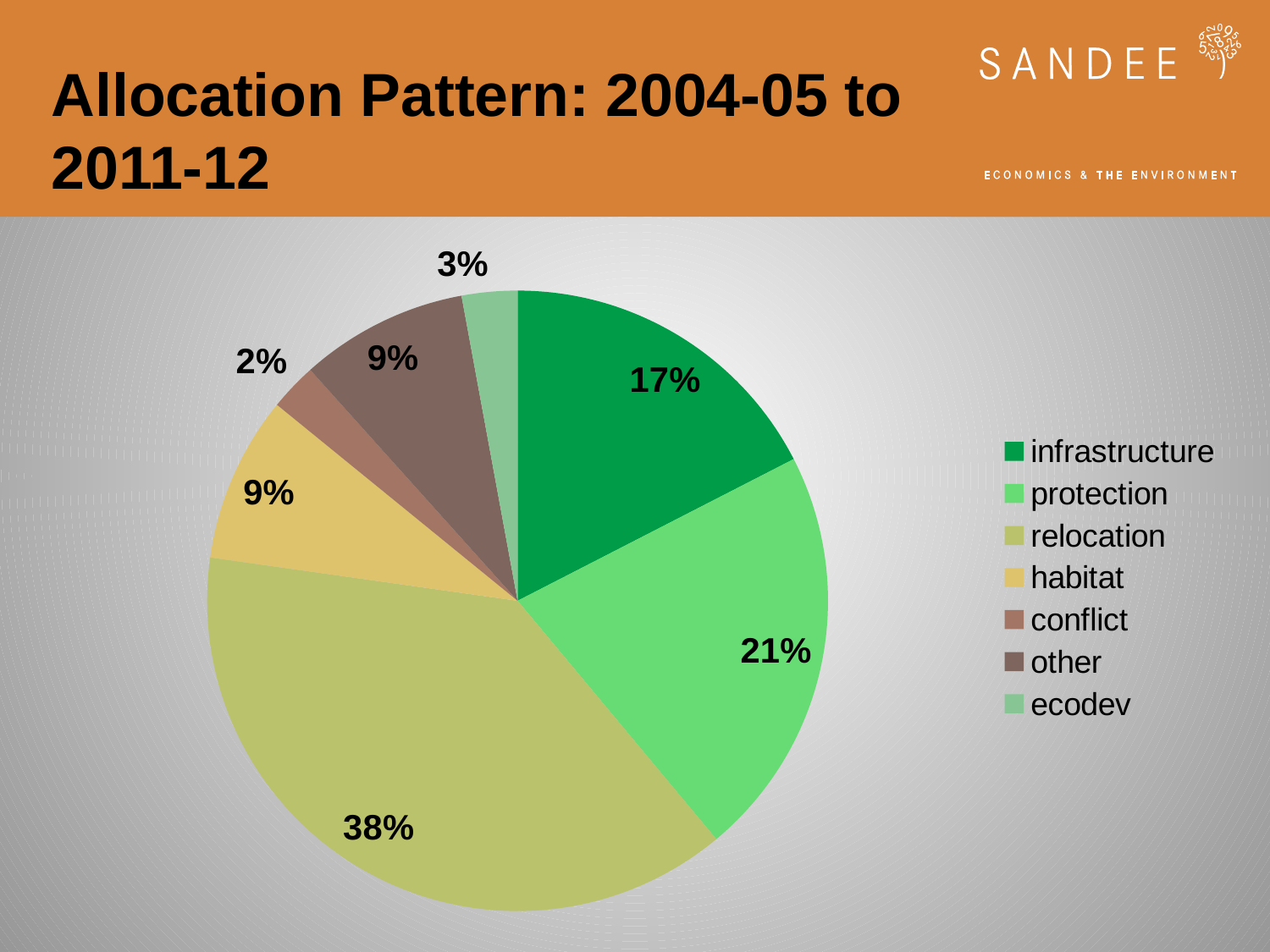
What is the value for conflict? 2% What is the title of the slide containing the chart? Allocation Pattern: 2004-05 to 2011-12 Which is larger, the share for infrastructure or the share for protection? protection What is the value for ecodev? 3% What share of the allocation goes to protection? 21% What share of the allocation goes to relocation? 38% What is the value for infrastructure? 17% How many categories does the legend list? 7 What type of chart is shown on the slide? pie chart Which category has the smallest share of the pie? conflict Which category has the largest share of the pie? relocation What is the difference in percentage points between relocation and protection? 17